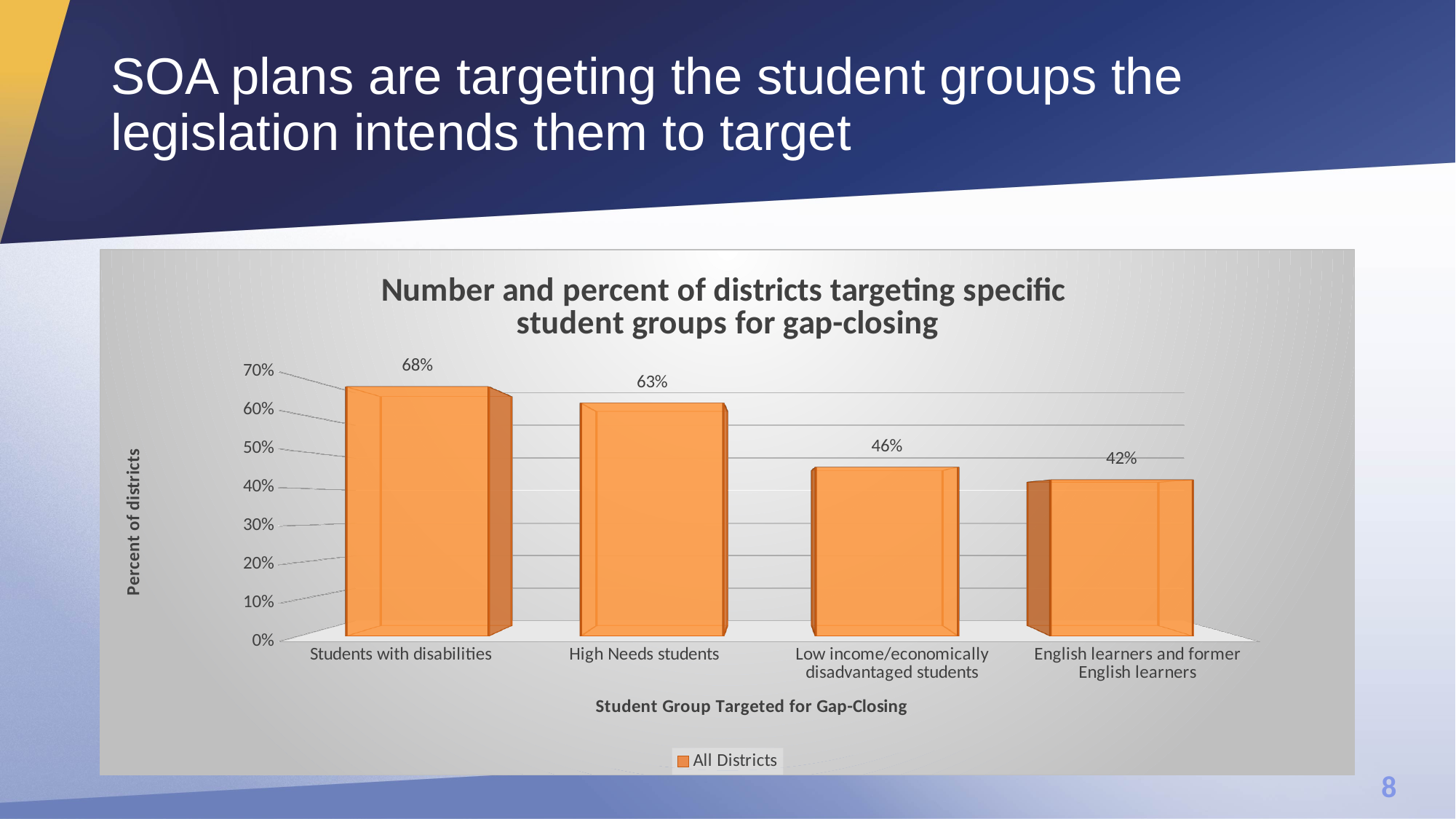
What is the label of the series in the legend? All Districts What is the difference in percentage points between Students with disabilities and English learners and former English learners? 26 What percent of districts target English learners and former English learners? 42% Which is larger: the value for High Needs students or the value for Low income/economically disadvantaged students? High Needs students What percent of districts target Low income/economically disadvantaged students? 46% How many student groups are shown on the x axis? 4 What kind of chart is shown on the slide? Bar chart Which student group is targeted by the lowest percent of districts? English learners and former English learners What percent of districts target Students with disabilities for gap-closing? 68% How many series does the legend list? 1 Which student group is targeted by the highest percent of districts? Students with disabilities What percent of districts target High Needs students? 63%